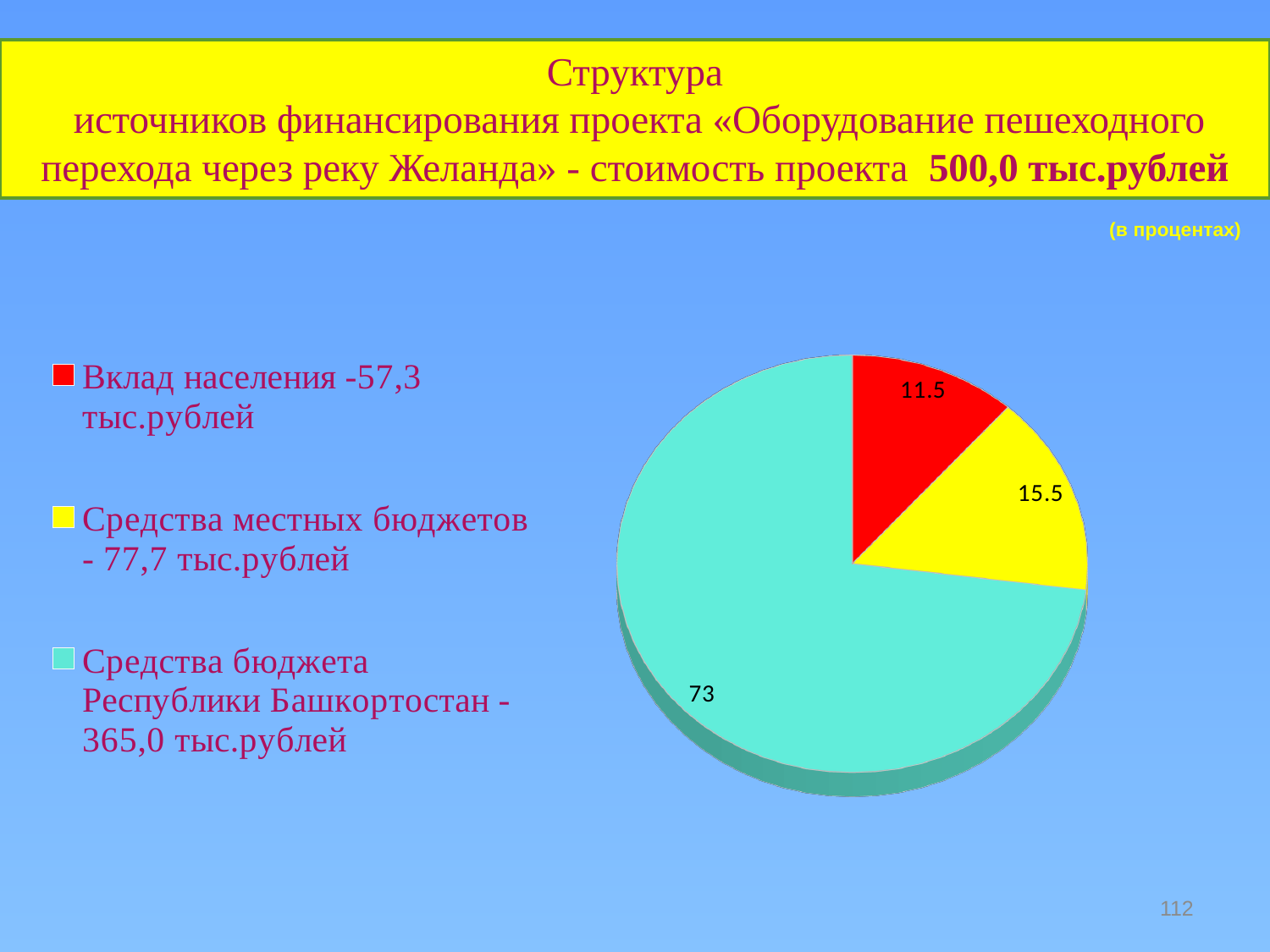
How many slices does the pie chart have? 3 What percentage is shown for the slice "Вклад населения"? 11.5 Which is larger: the share for "Вклад населения" or the share for "Средства местных бюджетов"? Средства местных бюджетов According to the legend, what amount in тыс.рублей corresponds to "Средства местных бюджетов"? 77,7 тыс.рублей What is the difference in percentage points between "Средства бюджета Республики Башкортостан" and "Средства местных бюджетов"? 57.5 What is the difference in percentage points between "Средства местных бюджетов" and "Вклад населения"? 4 What colour is the slice for "Вклад населения"? red Which funding source has the smallest share of the pie? Вклад населения Which funding source has the largest share of the pie? Средства бюджета Республики Башкортостан What type of chart is shown on the slide? pie chart What percentage is shown for the slice "Средства местных бюджетов"? 15.5 What percentage is shown for the slice "Средства бюджета Республики Башкортостан"? 73